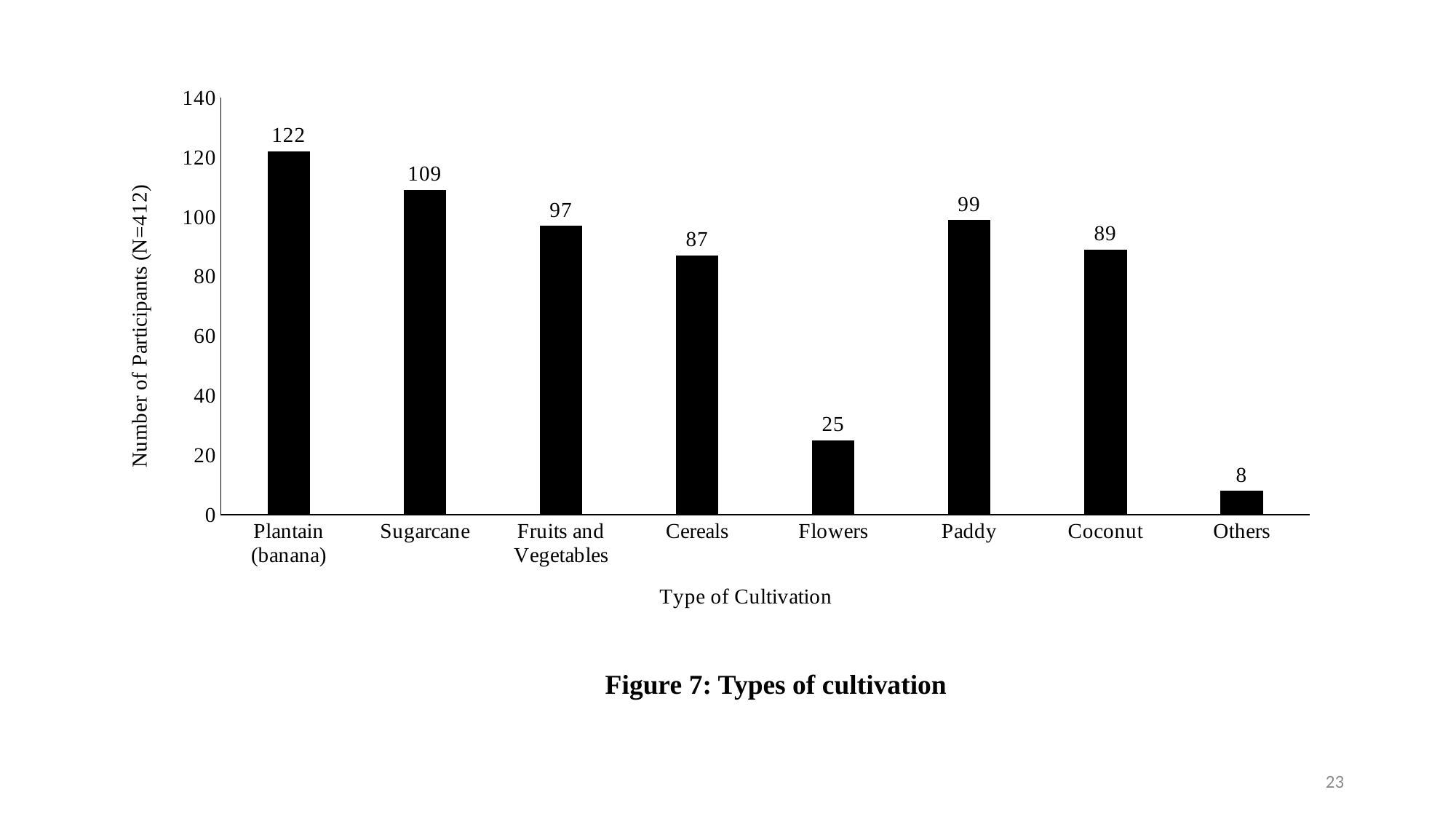
Which type of cultivation has the lowest number of participants? Others What is the difference between the values for Sugarcane and Cereals? 22 What is the value shown for Flowers? 25 What is the label of the y axis? Number of Participants (N=412) How many participants reported Plantain (banana) cultivation? 122 How many types of cultivation are shown on the x axis? 8 Which has more participants, Paddy or Coconut? Paddy What kind of chart is shown on the slide? Bar chart Is the value for Fruits and Vegetables greater or less than 100? less What is the figure caption shown below the chart? Figure 7: Types of cultivation What is the number of participants for Paddy? 99 Which type of cultivation has the highest number of participants? Plantain (banana)